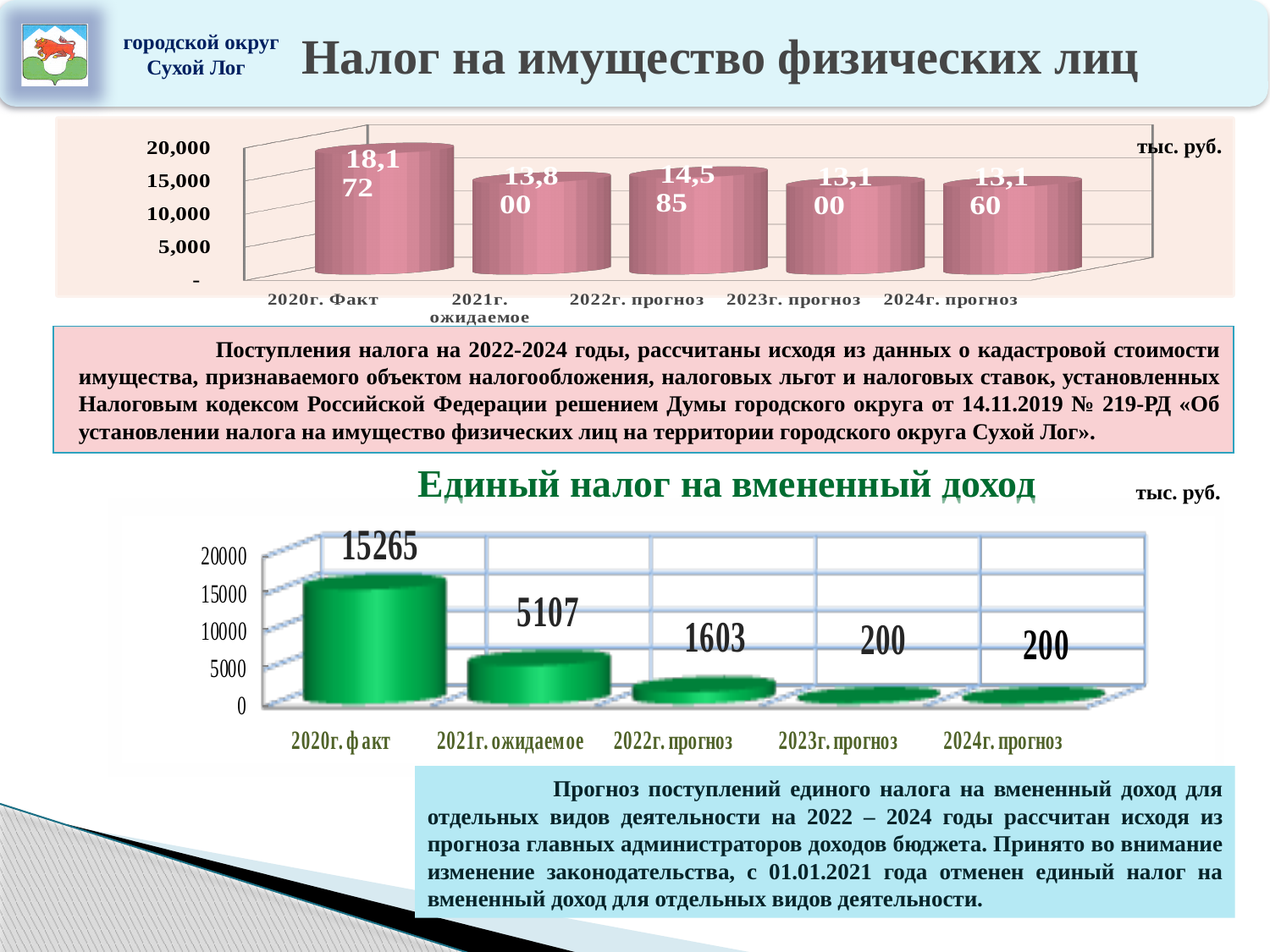
In the chart titled 'Единый налог на вмененный доход', what is the value for 2022г. прогноз? 1603 In the chart titled 'Единый налог на вмененный доход', what is the difference between the values for 2020г. факт and 2021г. ожидаемое? 10158 In the chart titled 'Единый налог на вмененный доход', what is the value for 2021г. ожидаемое? 5107 In the chart titled 'Единый налог на вмененный доход', how many categories are shown on the x axis? 5 What kind of chart is the one titled 'Единый налог на вмененный доход'? bar chart In the top chart (Налог на имущество физических лиц), what is the value for 2022г. прогноз? 14,585 In the top chart (Налог на имущество физических лиц), which category has the highest value? 2020г. Факт In the chart titled 'Единый налог на вмененный доход', which category has the highest value? 2020г. факт In the top chart (Налог на имущество физических лиц), what is the value for 2020г. Факт? 18,172 In the chart titled 'Единый налог на вмененный доход', what is the value for 2020г. факт? 15265 In the chart titled 'Единый налог на вмененный доход', do the values rise or fall from 2020г. факт to 2024г. прогноз? fall In the top chart (Налог на имущество физических лиц), is the value for 2021г. ожидаемое greater or less than 15,000? less